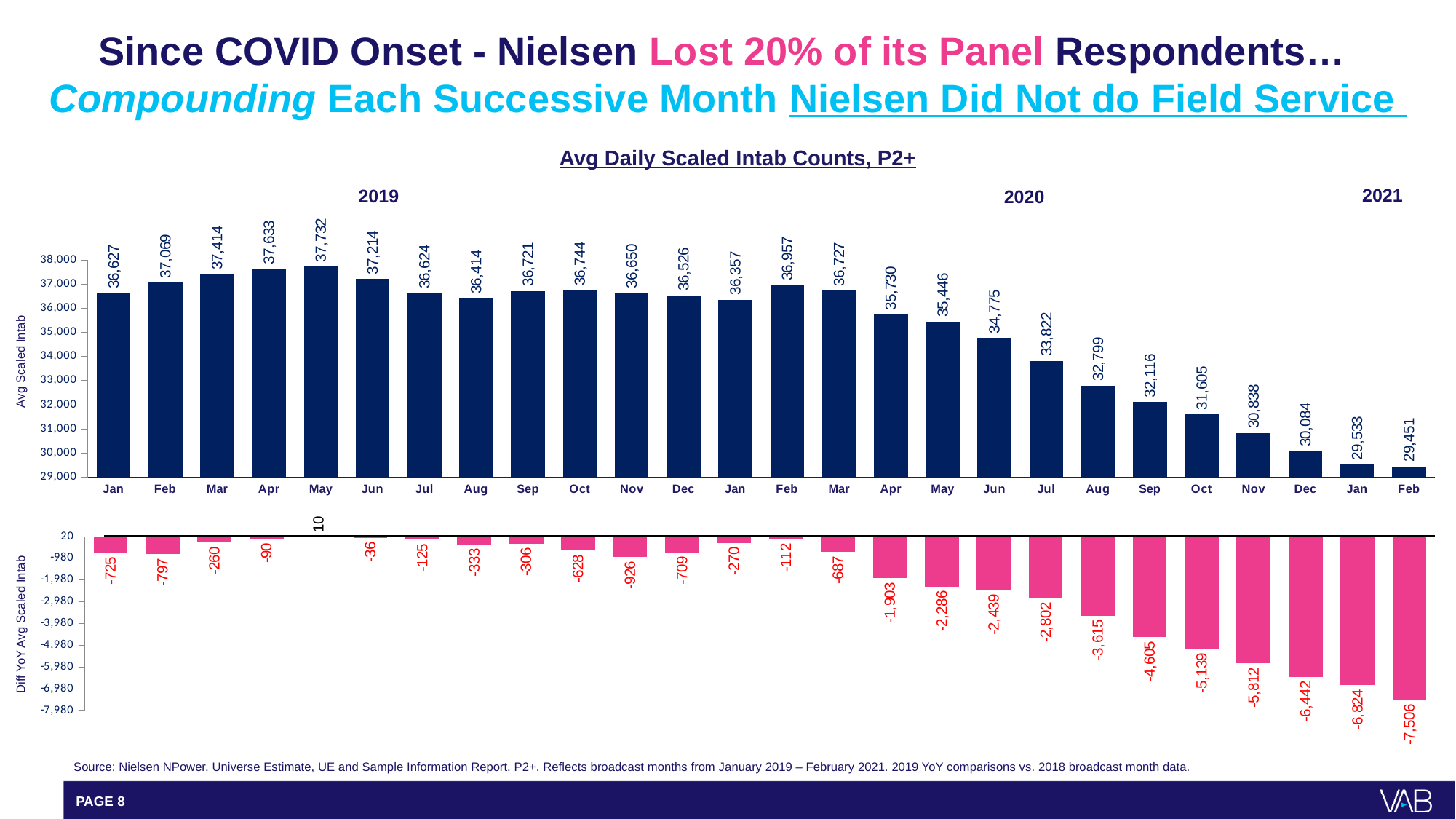
In the top chart (Avg Daily Scaled Intab Counts, P2+), what is the difference between Jan 2020 and Jan 2021? 6,824 In the bottom chart (Diff YoY Avg Scaled Intab), which month has the lowest value? Feb 2021 In the top chart (Avg Daily Scaled Intab Counts, P2+), what is the value for May 2019? 37,732 In the top chart (Avg Daily Scaled Intab Counts, P2+), which month has the lowest value? Feb 2021 In the top chart (Avg Daily Scaled Intab Counts, P2+), which is larger: Feb 2019 or Feb 2020? Feb 2019 In the bottom chart (Diff YoY Avg Scaled Intab), what is the value for Dec 2020? -6,442 What kind of chart is the top chart (Avg Daily Scaled Intab Counts, P2+)? Bar chart In the bottom chart (Diff YoY Avg Scaled Intab), which month has the highest value? May 2019 In the top chart (Avg Daily Scaled Intab Counts, P2+), what is the value for Feb 2021? 29,451 In the top chart (Avg Daily Scaled Intab Counts, P2+), do the values rise or fall from Mar 2020 to Feb 2021? Fall In the top chart (Avg Daily Scaled Intab Counts, P2+), which month has the highest value? May 2019 How many monthly bars are plotted in the top chart (Avg Daily Scaled Intab Counts, P2+)? 26